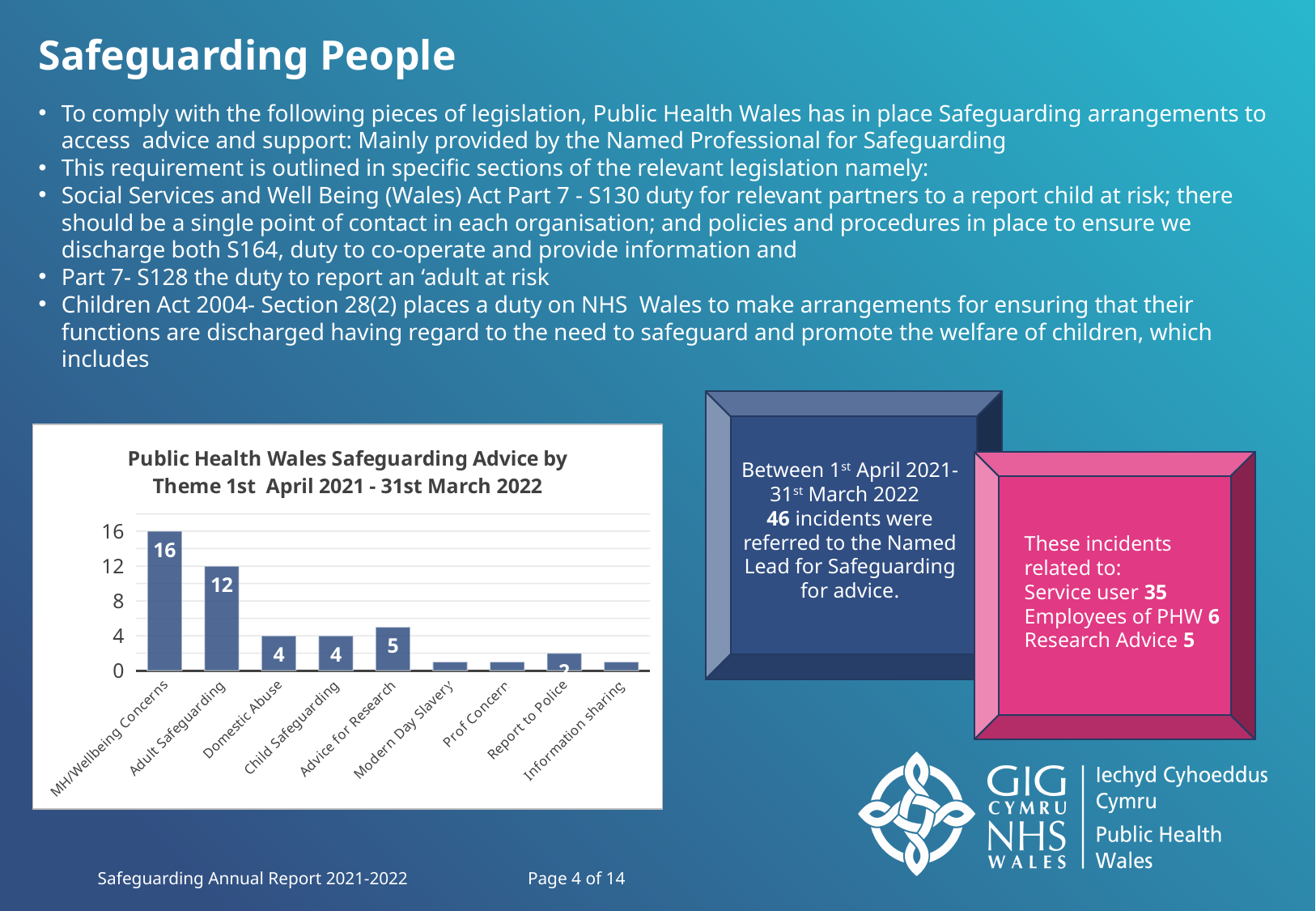
What is the value for Advice for Research? 5 What kind of chart is shown on the slide? bar chart Is the value for Information sharing greater or less than 4? less Which is larger, the value for Advice for Research or the value for Child Safeguarding? Advice for Research How many themes are shown on the x axis of the chart? 9 Which theme has the highest value? MH/Wellbeing Concerns What is the value for Adult Safeguarding? 12 What is the value for MH/Wellbeing Concerns? 16 What is the title of the chart? Public Health Wales Safeguarding Advice by Theme 1st April 2021 - 31st March 2022 What is the difference between the values for MH/Wellbeing Concerns and Adult Safeguarding? 4 What is the value for Domestic Abuse? 4 Is the value for Modern Day Slavery greater or less than 4? less